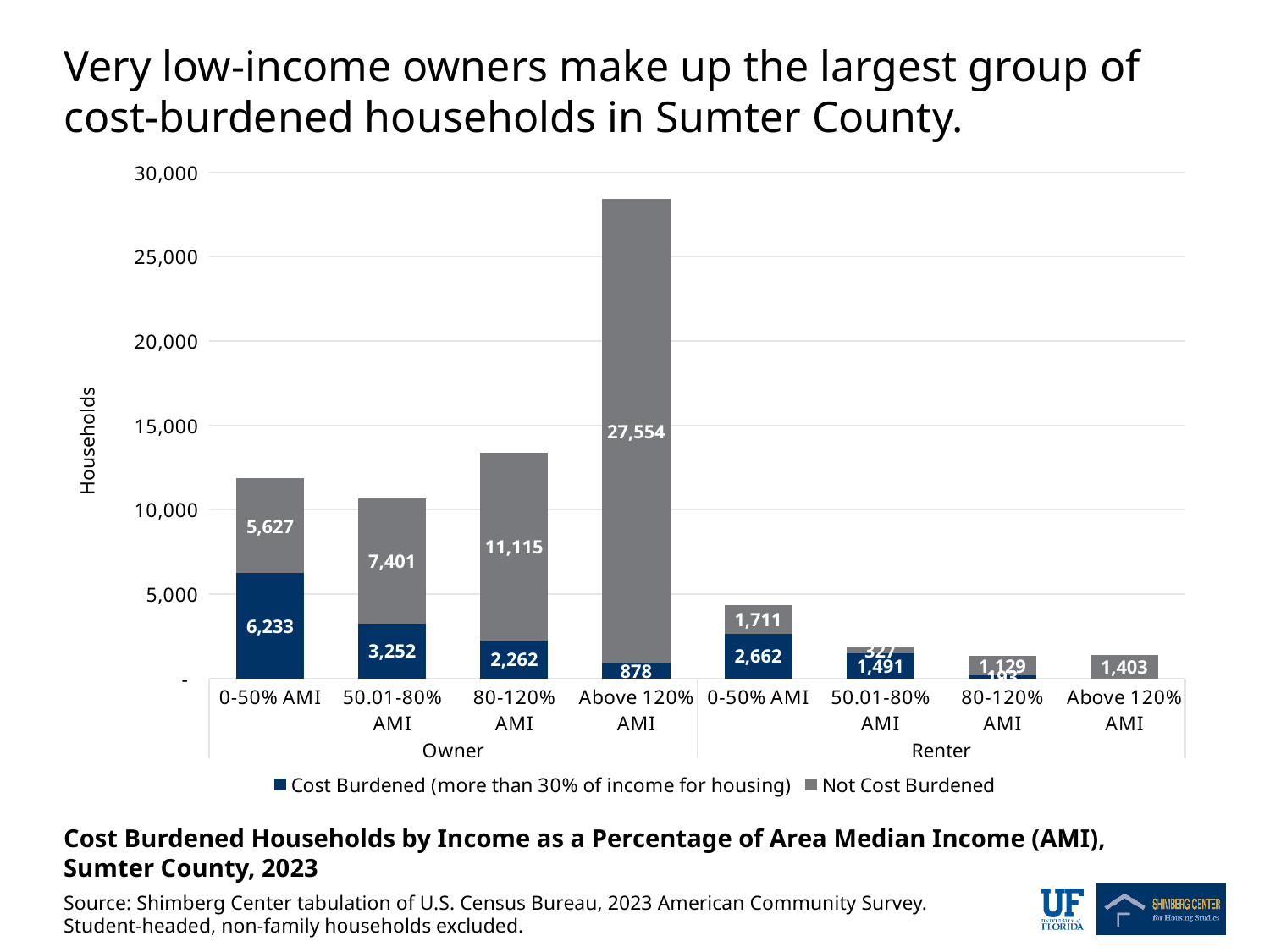
What is the difference between cost-burdened owner households and cost-burdened renter households in the 0-50% AMI category? 3,571 Which category has the smallest number of not-cost-burdened households? Renter 50.01-80% AMI What type of chart is shown on the slide? Stacked bar chart How many income categories (bars) are plotted across the Owner and Renter groups? 8 How many cost-burdened renter households are in the 50.01-80% AMI category? 1,491 Is the total height of the Owner Above 120% AMI bar greater or less than 25,000? greater Which is larger: the number of cost-burdened owner households at 50.01-80% AMI or the number of cost-burdened renter households at 0-50% AMI? Cost-burdened owner households at 50.01-80% AMI How many series does the legend list? 2 Which category has the largest number of cost-burdened households? Owner 0-50% AMI How many not-cost-burdened owner households are in the Above 120% AMI category? 27,554 What is the total number of owner households in the 0-50% AMI category (cost burdened plus not cost burdened)? 11,860 How many cost-burdened owner households are in the 0-50% AMI category? 6,233